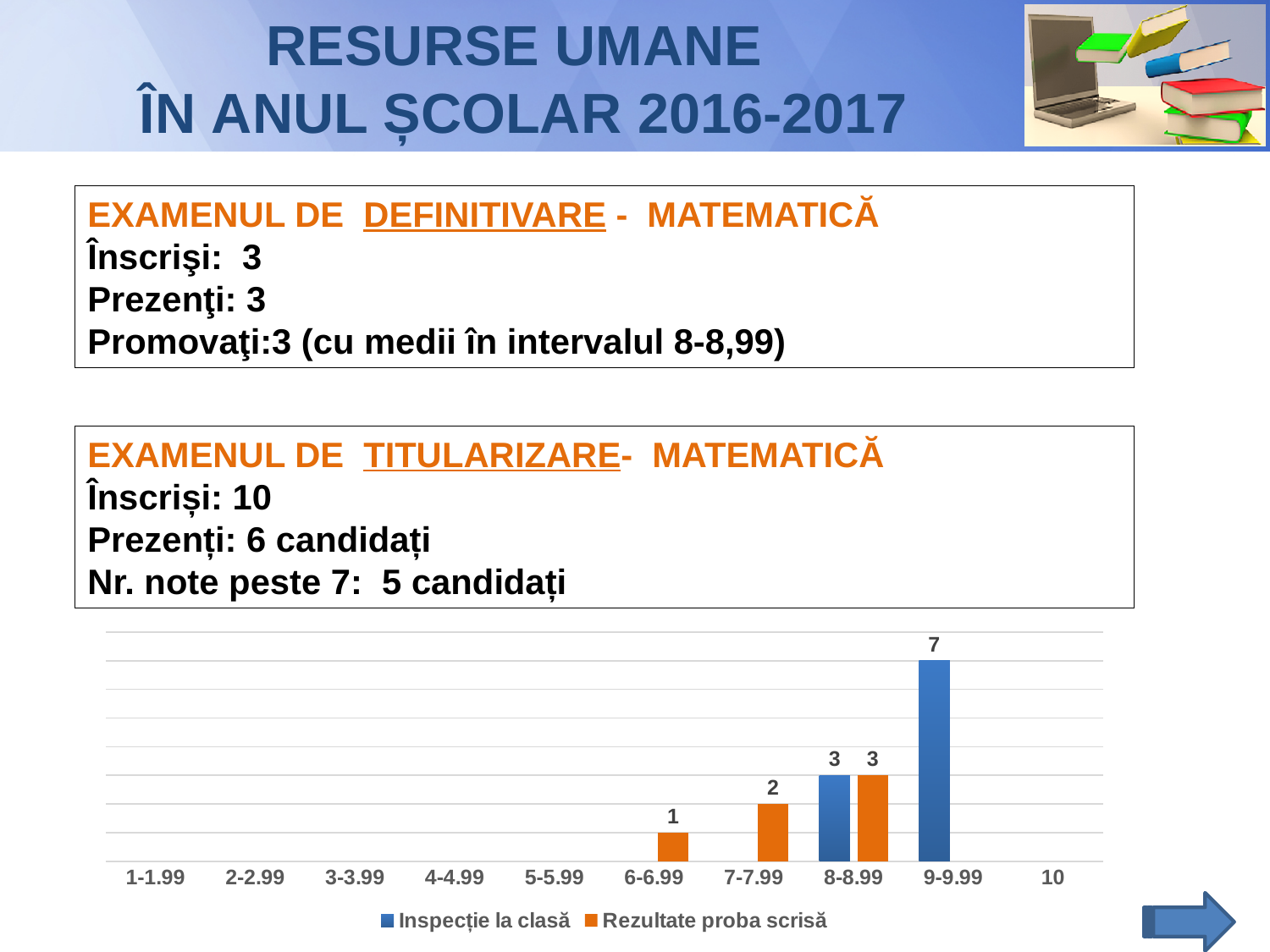
What is the value of 'Inspecție la clasă' for the 8-8.99 category? 3 Which is larger: 'Rezultate proba scrisă' for 7-7.99 or 'Rezultate proba scrisă' for 6-6.99? 7-7.99 What is the value of 'Rezultate proba scrisă' for the 6-6.99 category? 1 Which category has the highest value for 'Rezultate proba scrisă'? 8-8.99 How many categories are shown on the x axis of the chart? 10 How many series does the chart legend list? 2 Which series in the chart legend is shown in orange? Rezultate proba scrisă What is the difference between the 'Inspecție la clasă' value for 9-9.99 and the 'Inspecție la clasă' value for 8-8.99? 4 What kind of chart is shown on the slide? bar chart Which category has the highest value for 'Inspecție la clasă'? 9-9.99 What is the value of 'Rezultate proba scrisă' for the 7-7.99 category? 2 What is the value of 'Inspecție la clasă' for the 9-9.99 category? 7